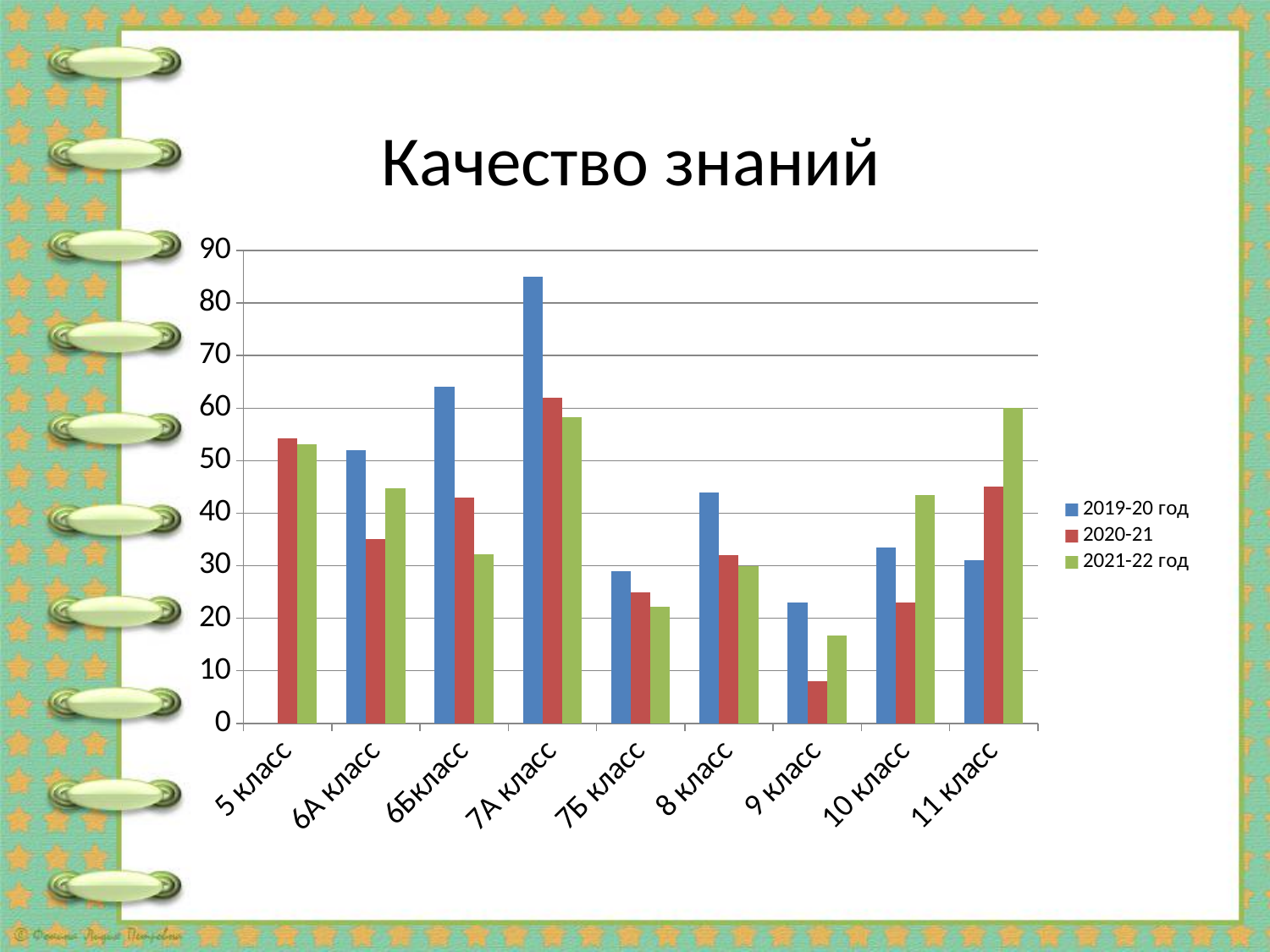
How many class categories are shown on the x axis? 9 Is the 2019-20 год value for 6Бкласс greater or less than 60? greater For 10 класс, which series has the larger value: 2020-21 or 2021-22 год? 2021-22 год Which class has the lowest value for the 2020-21 series? 9 класс Is the 2019-20 год value for 7А класс greater or less than 80? greater How many series does the legend list? 3 What type of chart is shown on the slide? bar chart For 6Бкласс, which series has the larger value: 2019-20 год or 2021-22 год? 2019-20 год Which class has the lowest value for the 2021-22 год series? 9 класс Is the 2020-21 value for 9 класс greater or less than 10? less Which class has the highest value for the 2019-20 год series? 7А класс What is the title of the chart? Качество знаний